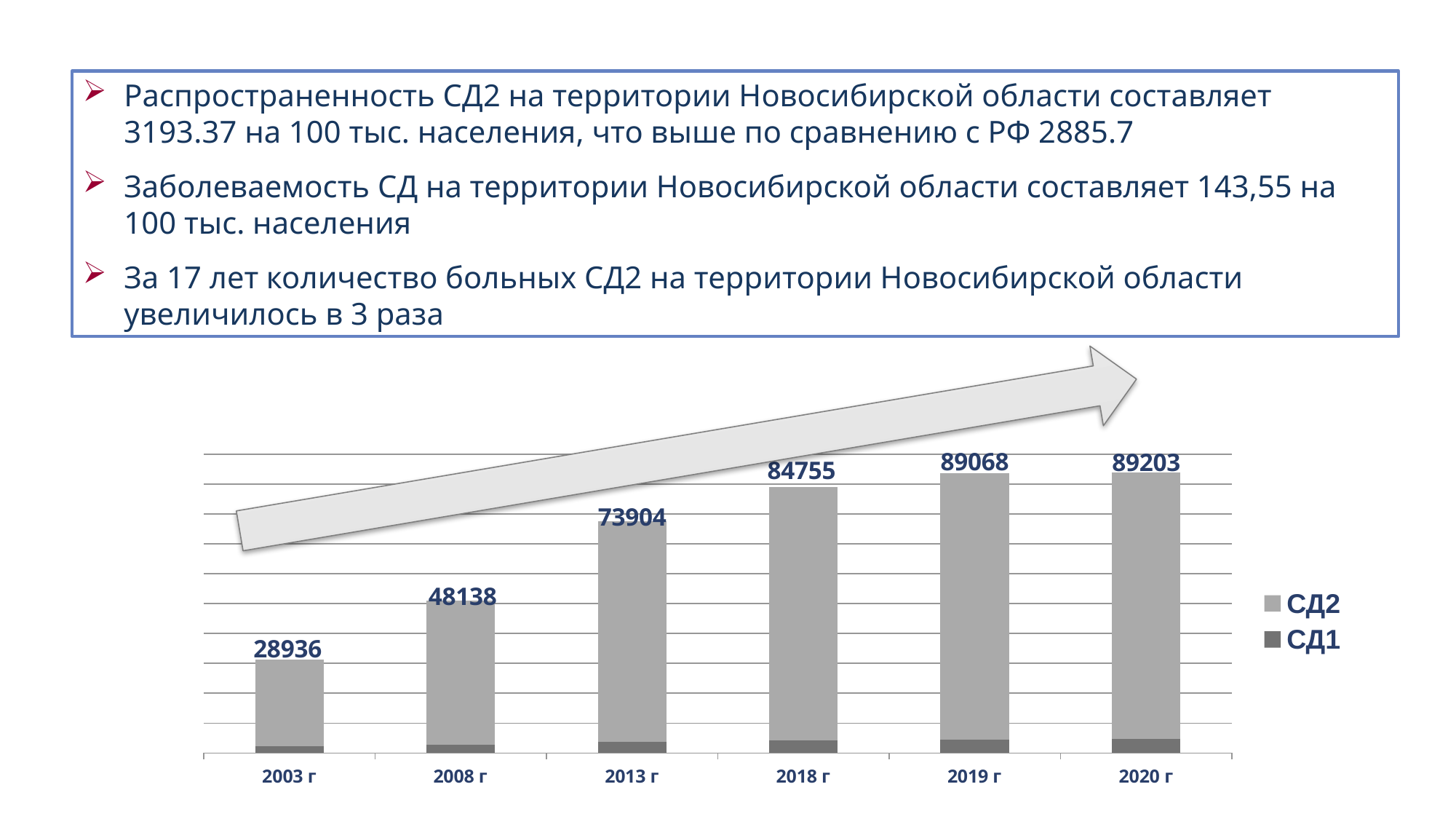
How many years are shown on the x axis? 6 What is the difference between the values printed for 2020 г and 2019 г? 135 Which year has the shortest bar? 2003 г Which year has the tallest bar? 2020 г What value is printed above the bar for 2003 г? 28936 Which bar is taller, 2008 г or 2013 г? 2013 г What is the difference between the values printed for 2008 г and 2003 г? 19202 What value is printed above the bar for 2013 г? 73904 Do the bar values rise or fall from 2003 г to 2020 г? Rise What kind of chart is shown on the slide? Stacked bar chart What value is printed above the bar for 2019 г? 89068 How many series does the legend list? 2